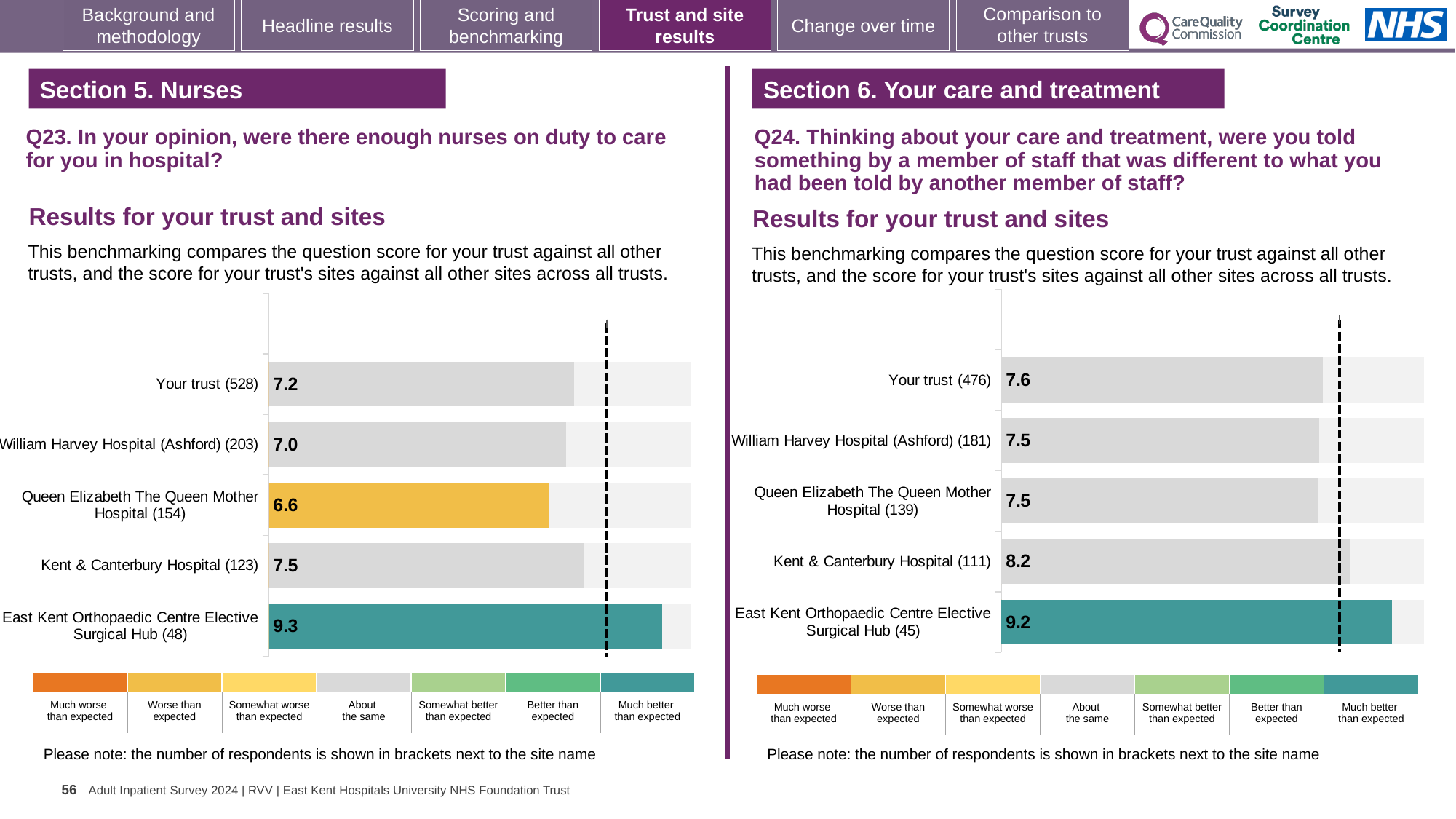
On the Q23 chart (left), which site has the highest score? East Kent Orthopaedic Centre Elective Surgical Hub (48) On the Q24 chart (right), what is the score for Kent & Canterbury Hospital (111)? 8.2 On the Q24 chart (right), what is the score for Your trust (476)? 7.6 What type of chart is used on the Q23 chart (left)? Bar chart On the Q23 chart (left), how many bars are plotted? 5 On the Q23 chart (left), what is the score for Your trust (528)? 7.2 On the Q24 chart (right), what is the difference between the scores for East Kent Orthopaedic Centre Elective Surgical Hub (45) and Your trust (476)? 1.6 On the Q23 chart (left), what is the difference between the scores for East Kent Orthopaedic Centre Elective Surgical Hub (48) and Kent & Canterbury Hospital (123)? 1.8 On the Q23 chart (left), what is the score for Queen Elizabeth The Queen Mother Hospital (154)? 6.6 On the Q23 chart (left), which site has the lowest score? Queen Elizabeth The Queen Mother Hospital (154) On the Q24 chart (right), which is larger: the score for William Harvey Hospital (Ashford) (181) or the score for Kent & Canterbury Hospital (111)? Kent & Canterbury Hospital (111) On the Q24 chart (right), which site has the highest score? East Kent Orthopaedic Centre Elective Surgical Hub (45)